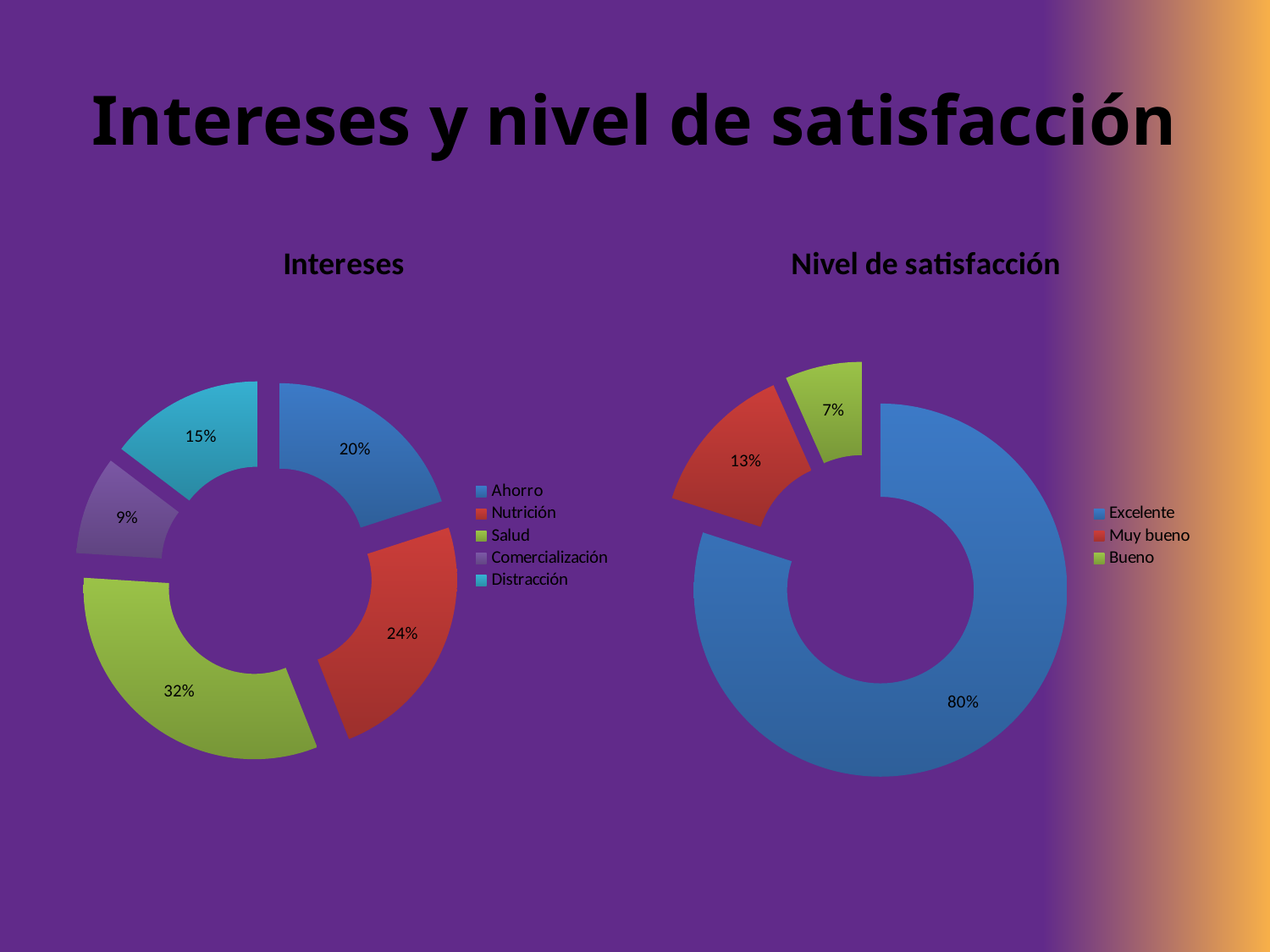
In the 'Intereses' chart, what is the difference between Nutrición and Distracción? 9% In the 'Intereses' chart, which category has the smallest share? Comercialización What kind of chart is the 'Nivel de satisfacción' chart? Doughnut (pie) chart In the 'Nivel de satisfacción' chart, what is the value for Muy bueno? 13% In the 'Nivel de satisfacción' chart, what is the difference between Excelente and Bueno? 73% In the 'Nivel de satisfacción' chart, which category has the largest share? Excelente In the 'Intereses' chart, which is larger, Ahorro or Nutrición? Nutrición In the 'Intereses' chart, what is the value for Comercialización? 9% How many entries does the legend of the 'Nivel de satisfacción' chart list? 3 In the 'Intereses' chart, which category has the largest share? Salud How many categories does the 'Intereses' chart show? 5 In the 'Intereses' chart, what is the value for Salud? 32%